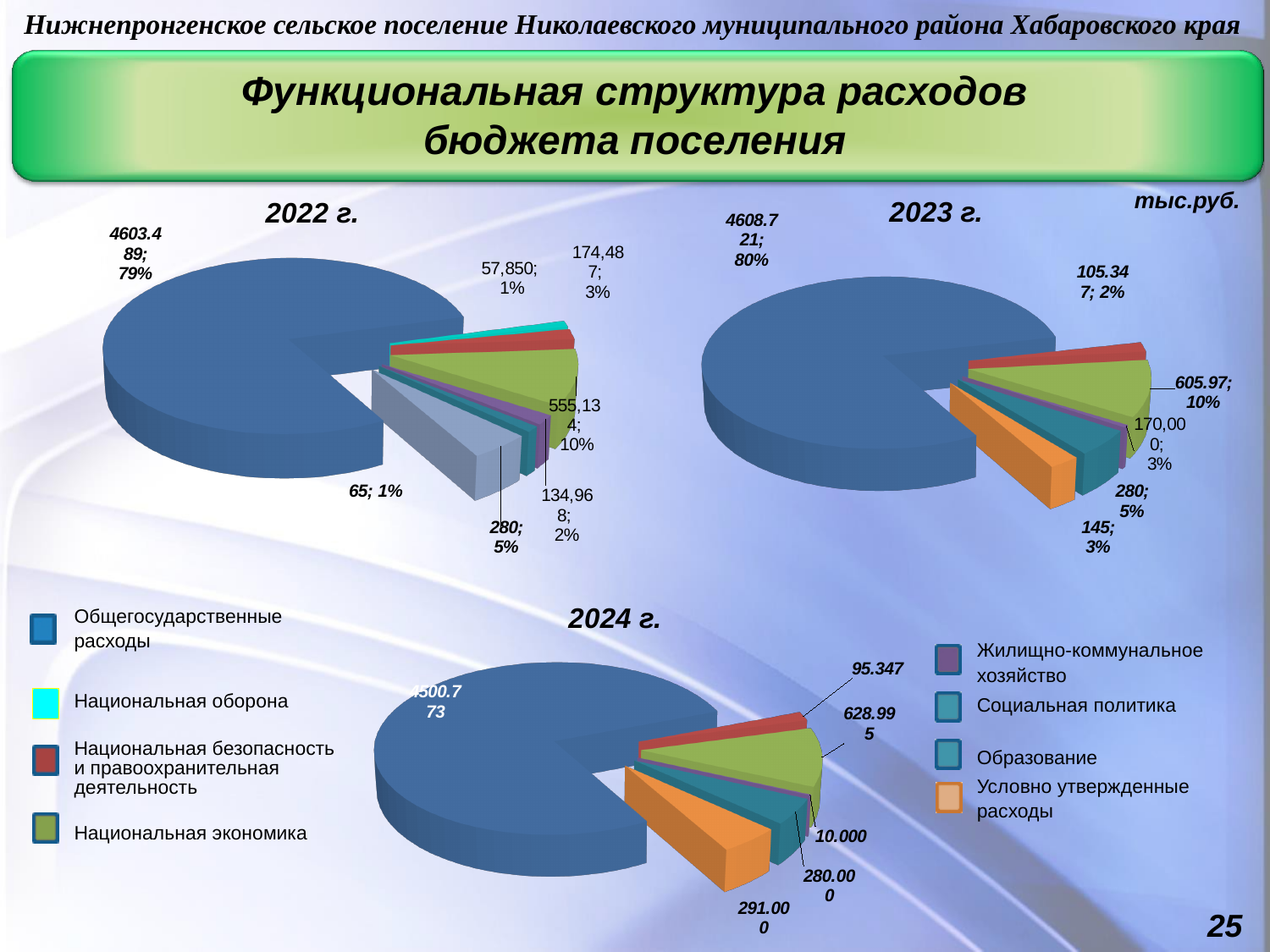
In the 2024 г. pie chart, what is the value for Общегосударственные расходы? 4500.773 In the 2023 г. pie chart, what share of expenditures is Общегосударственные расходы? 80% What unit of measurement is indicated for the charts on the slide? тыс.руб. In the 2023 г. pie chart, what is the value for Национальная экономика? 605.97 In the 2024 г. pie chart, which category has the largest slice? Общегосударственные расходы What kind of chart is used for the 2022 г. data on the slide? Pie chart In the 2023 г. pie chart, what share of expenditures is Условно утвержденные расходы? 3% How many categories does the legend list? 8 How many pie charts are shown on the slide? 3 In the 2022 г. pie chart, what is the value for Общегосударственные расходы? 4603.489 In the 2022 г. pie chart, what share of expenditures is Общегосударственные расходы? 79% In the 2024 г. pie chart, what is the value for Национальная экономика? 628.995